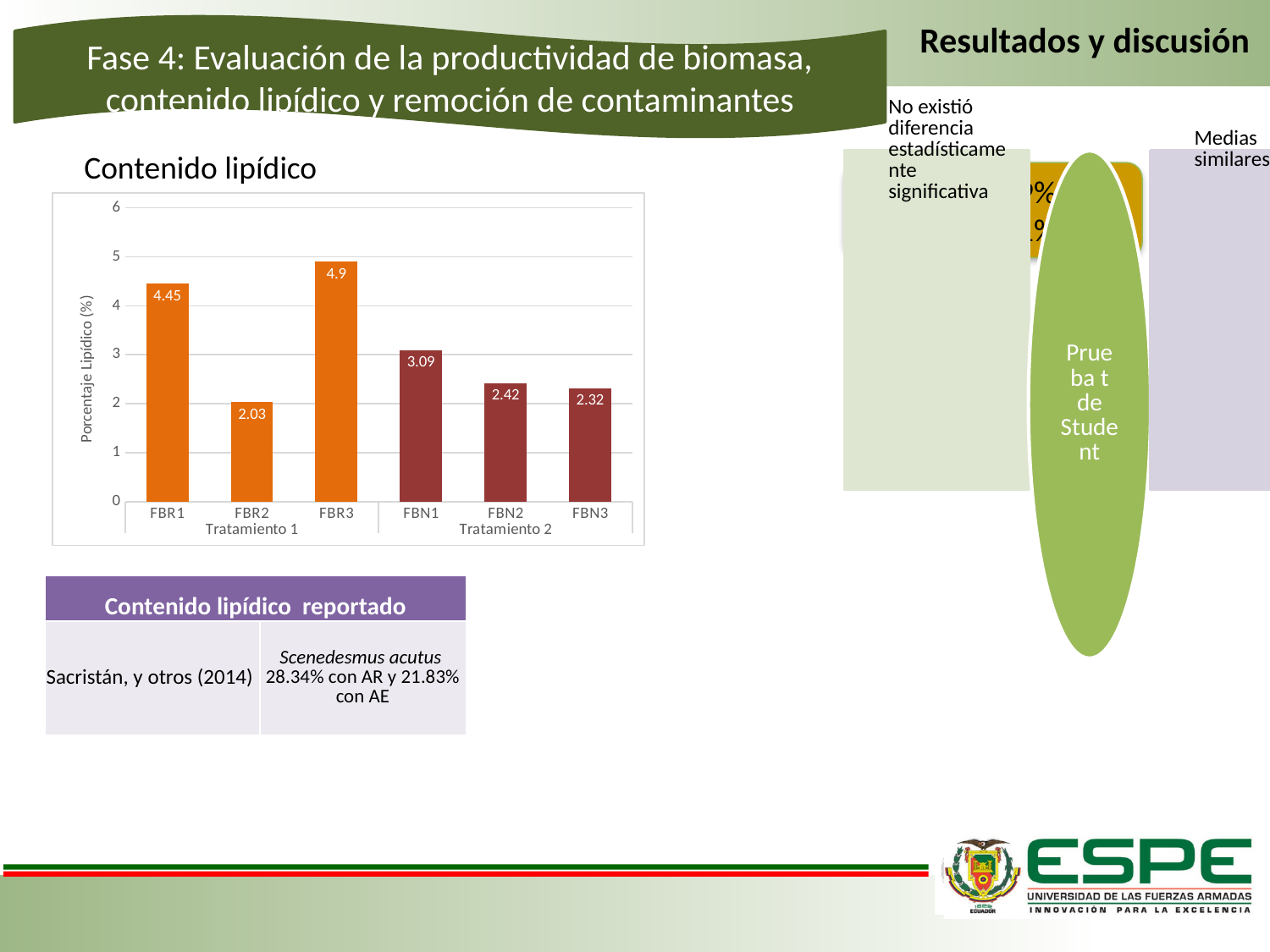
What is the y-axis label of the Contenido lipídico chart? Porcentaje Lipídico (%) Which category has the highest value in the Contenido lipídico chart? FBR3 How many bars are plotted in the Contenido lipídico chart? 6 What is the value for FBR2 in the Contenido lipídico chart? 2.03 What is the difference between the values for FBR1 and FBR2 in the Contenido lipídico chart? 2.42 Which category has the lowest value in the Contenido lipídico chart? FBR2 Is the value for FBN1 in the Contenido lipídico chart greater or less than 3? greater Which is larger in the Contenido lipídico chart, FBN1 or FBN3? FBN1 What is the difference between the values for FBR3 and FBN1 in the Contenido lipídico chart? 1.81 What is the value for FBR1 in the Contenido lipídico chart? 4.45 What is the value for FBN2 in the Contenido lipídico chart? 2.42 What kind of chart is the Contenido lipídico chart? Bar chart